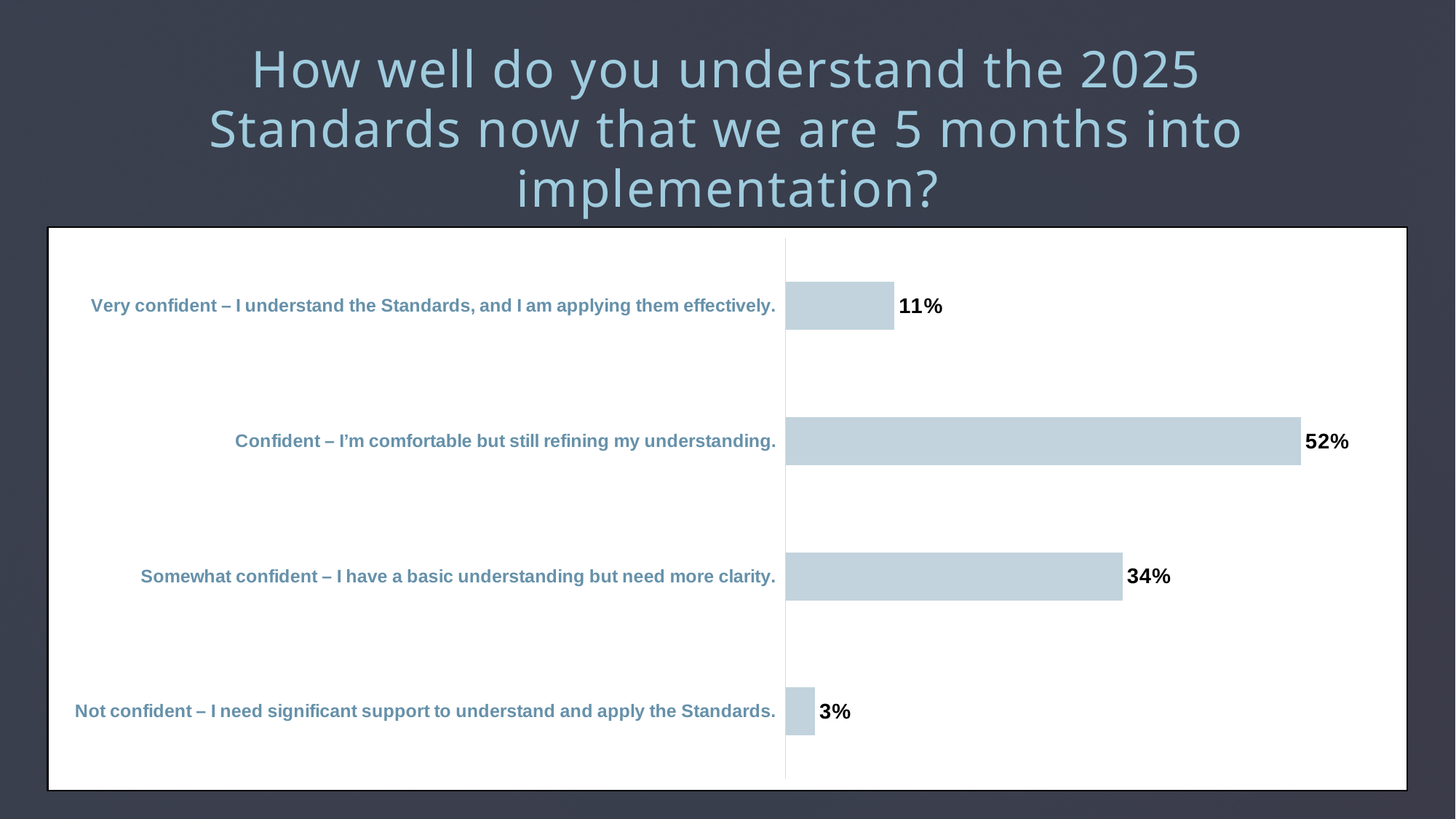
What percentage of respondents said they are 'Somewhat confident'? 34% What is the title of the slide containing the chart? How well do you understand the 2025 Standards now that we are 5 months into implementation? What percentage of respondents said they are 'Not confident'? 3% Which is larger, the percentage for 'Somewhat confident' or for 'Very confident'? Somewhat confident What kind of chart is shown on the slide? Bar chart Which response category has the highest percentage? Confident – I'm comfortable but still refining my understanding. What is the difference in percentage points between 'Confident' and 'Somewhat confident'? 18 What percentage of respondents said they are 'Very confident'? 11% How many response categories are shown in the chart? 4 What is the difference in percentage points between 'Very confident' and 'Not confident'? 8 Which response category has the lowest percentage? Not confident – I need significant support to understand and apply the Standards. What percentage of respondents said they are 'Confident'? 52%